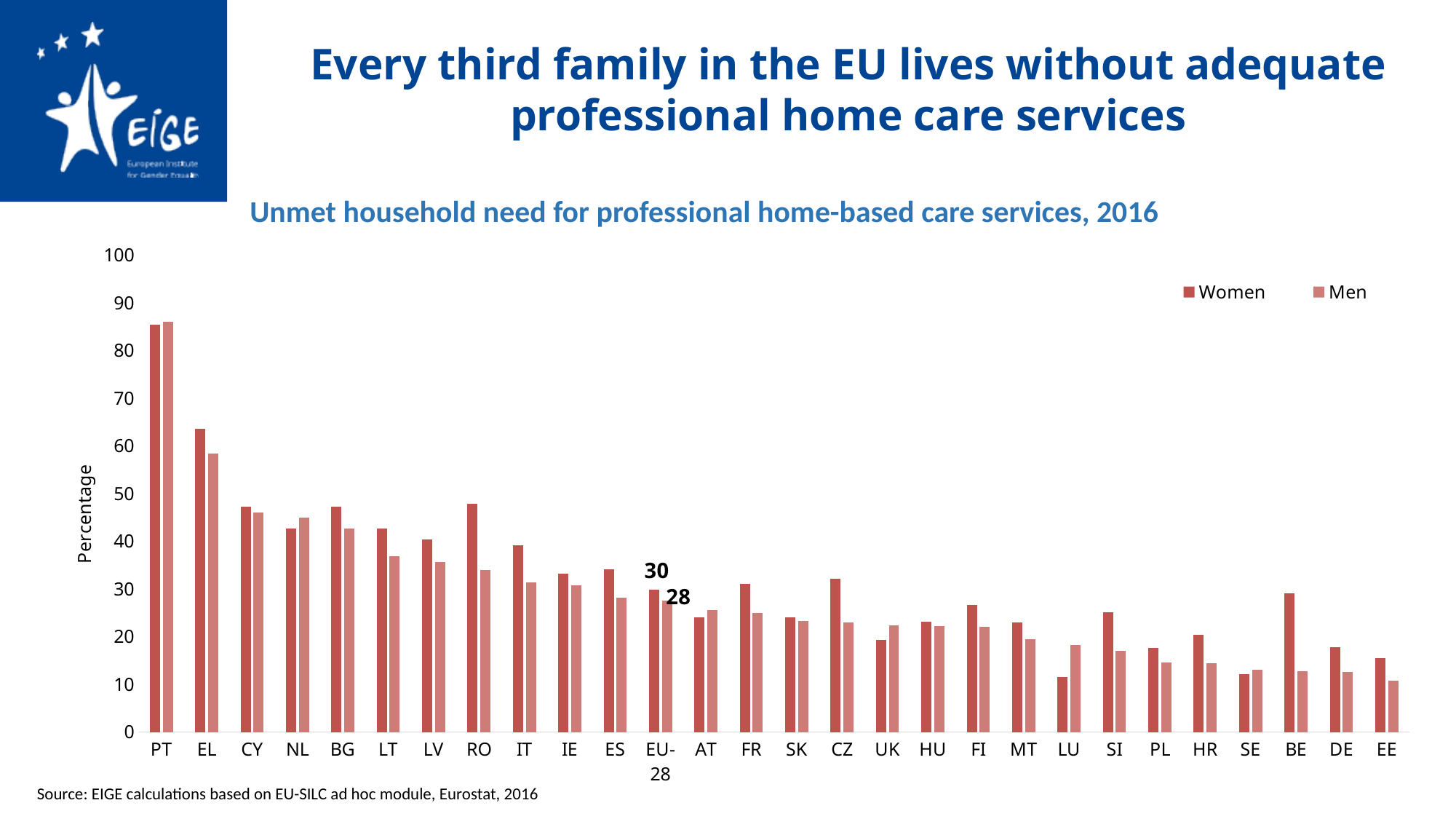
Is the value for Women for EE greater or less than 20? less Which is larger for RO, the Women value or the Men value? Women How many categories are shown on the x axis? 28 What is the difference between the Women and Men values for EU-28? 2 What is the value for Women for EU-28? 30 How many series does the legend list? 2 What is the value for Men for EU-28? 28 What kind of chart is shown on the slide? bar chart Which country has the highest value for Women? PT What is the label of the y axis? Percentage Is the value for Women for PT greater or less than 80? greater Which country has the highest value for Men? PT